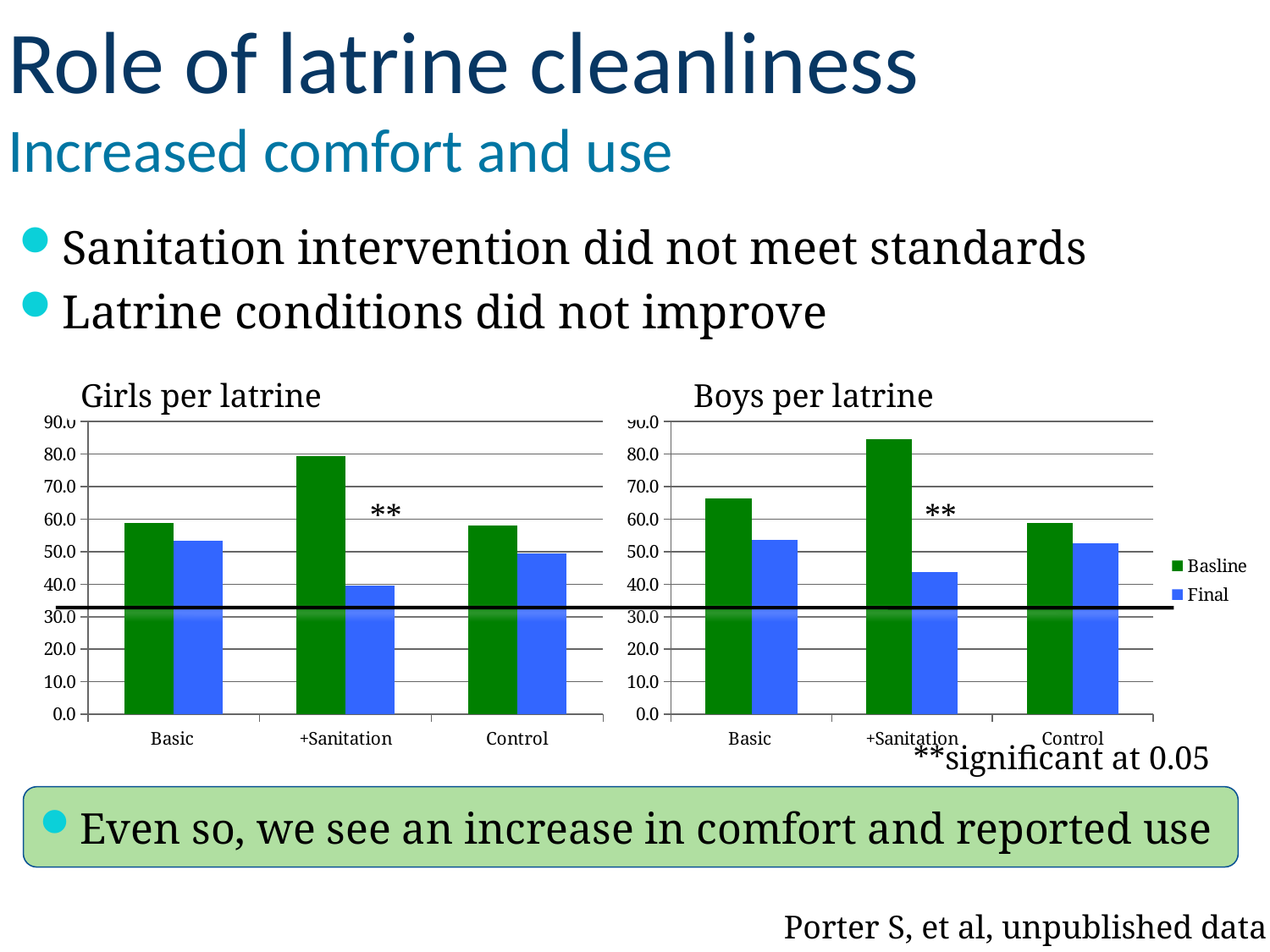
What are the two series named in the legend? Basline and Final How many series does the legend list for the charts? 2 In the 'Boys per latrine' chart, is the Final value for +Sanitation greater or less than 50.0? less In the 'Girls per latrine' chart, which category has the lowest Final value? +Sanitation In the 'Boys per latrine' chart, which category has the highest Basline value? +Sanitation In the 'Boys per latrine' chart, which is larger for Basic: the Basline value or the Final value? Basline What kind of chart is the 'Girls per latrine' chart? bar chart How many categories are shown on the x axis of the 'Boys per latrine' chart? 3 In the 'Boys per latrine' chart, which category has the lowest Final value? +Sanitation In the 'Girls per latrine' chart, is the Basline value for +Sanitation greater or less than 70.0? greater In the 'Girls per latrine' chart, which category has the highest Basline value? +Sanitation In the 'Girls per latrine' chart, is the Final value for Control greater or less than 40.0? greater